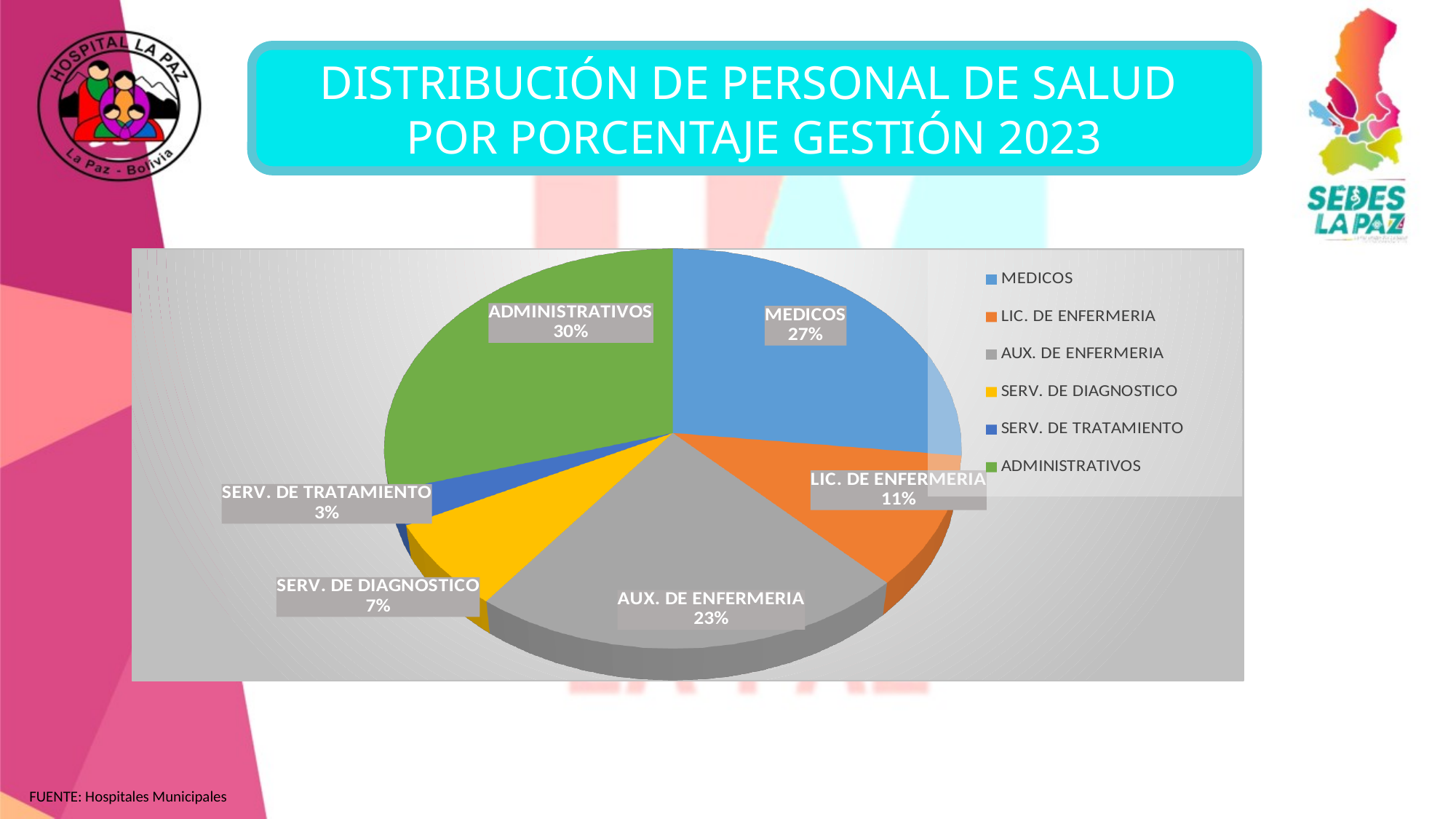
Which category has the largest share of the pie? ADMINISTRATIVOS Which is larger, the share for SERV. DE DIAGNOSTICO or the share for LIC. DE ENFERMERIA? LIC. DE ENFERMERIA What percentage of health personnel are SERV. DE TRATAMIENTO? 3% What kind of chart is shown on the slide? pie chart What is the difference in percentage points between MEDICOS and LIC. DE ENFERMERIA? 16 Which category has the smallest share of the pie? SERV. DE TRATAMIENTO What is the title of the slide containing the chart? DISTRIBUCIÓN DE PERSONAL DE SALUD POR PORCENTAJE GESTIÓN 2023 What percentage of health personnel are MEDICOS? 27% How many categories are shown in the pie chart? 6 What colour is the slice for SERV. DE DIAGNOSTICO? yellow What percentage of health personnel are ADMINISTRATIVOS? 30% What percentage of health personnel are AUX. DE ENFERMERIA? 23%